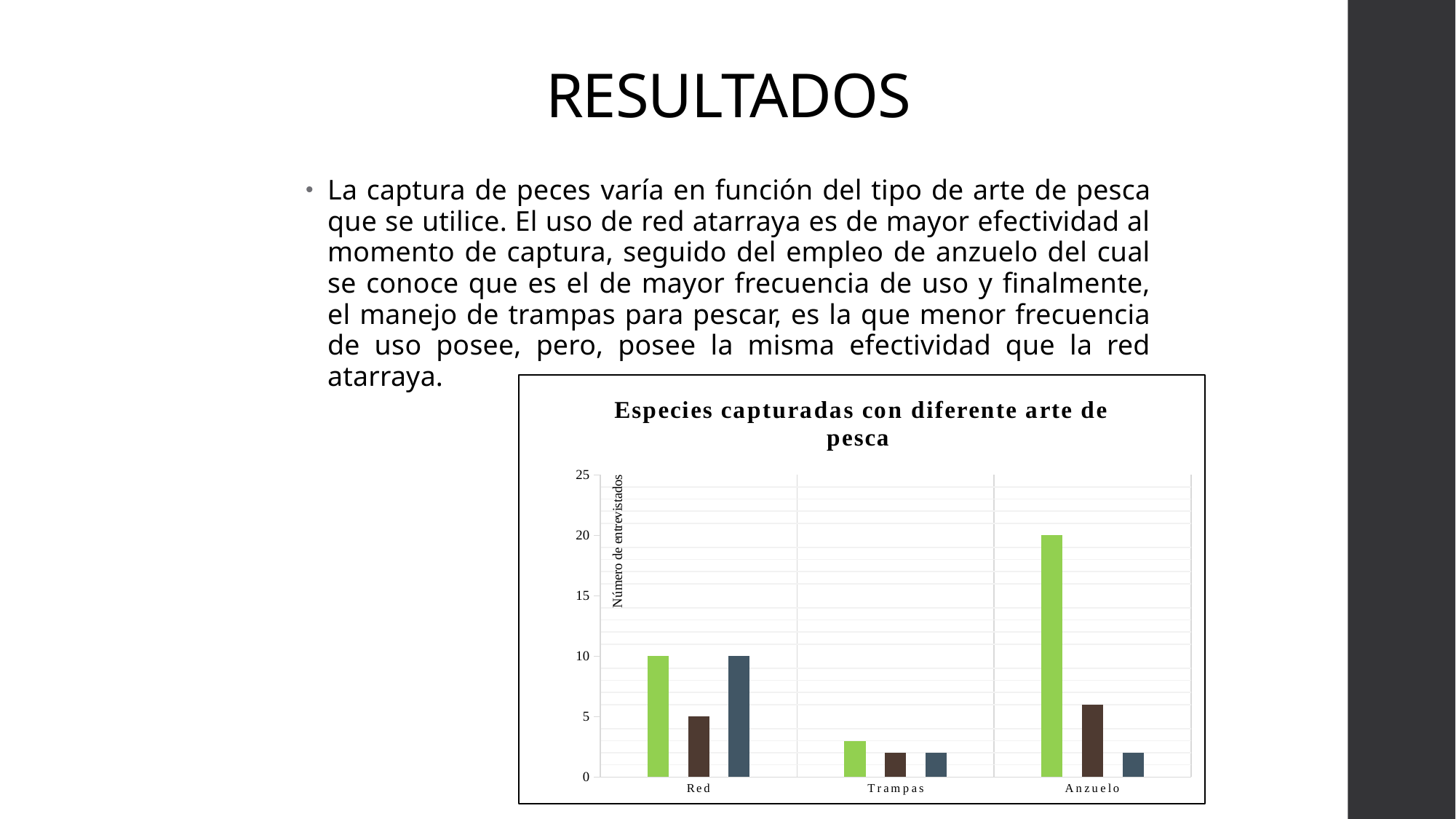
What is the label of the y axis of the chart? Número de entrevistados What type of chart is shown on the slide? bar chart What is the value of the green bar for Anzuelo? 20 What is the title of the chart? Especies capturadas con diferente arte de pesca How many categories are shown on the x axis of the chart? 3 Which category has the highest green bar? Anzuelo Which category has the lowest green bar? Trampas What is the value of the blue bar for Red? 10 What is the value of the green bar for Red? 10 What is the difference between the green bar for Anzuelo and the green bar for Red? 10 What is the value of the brown bar for Red? 5 Is the value of the green bar for Trampas greater or less than 5? less